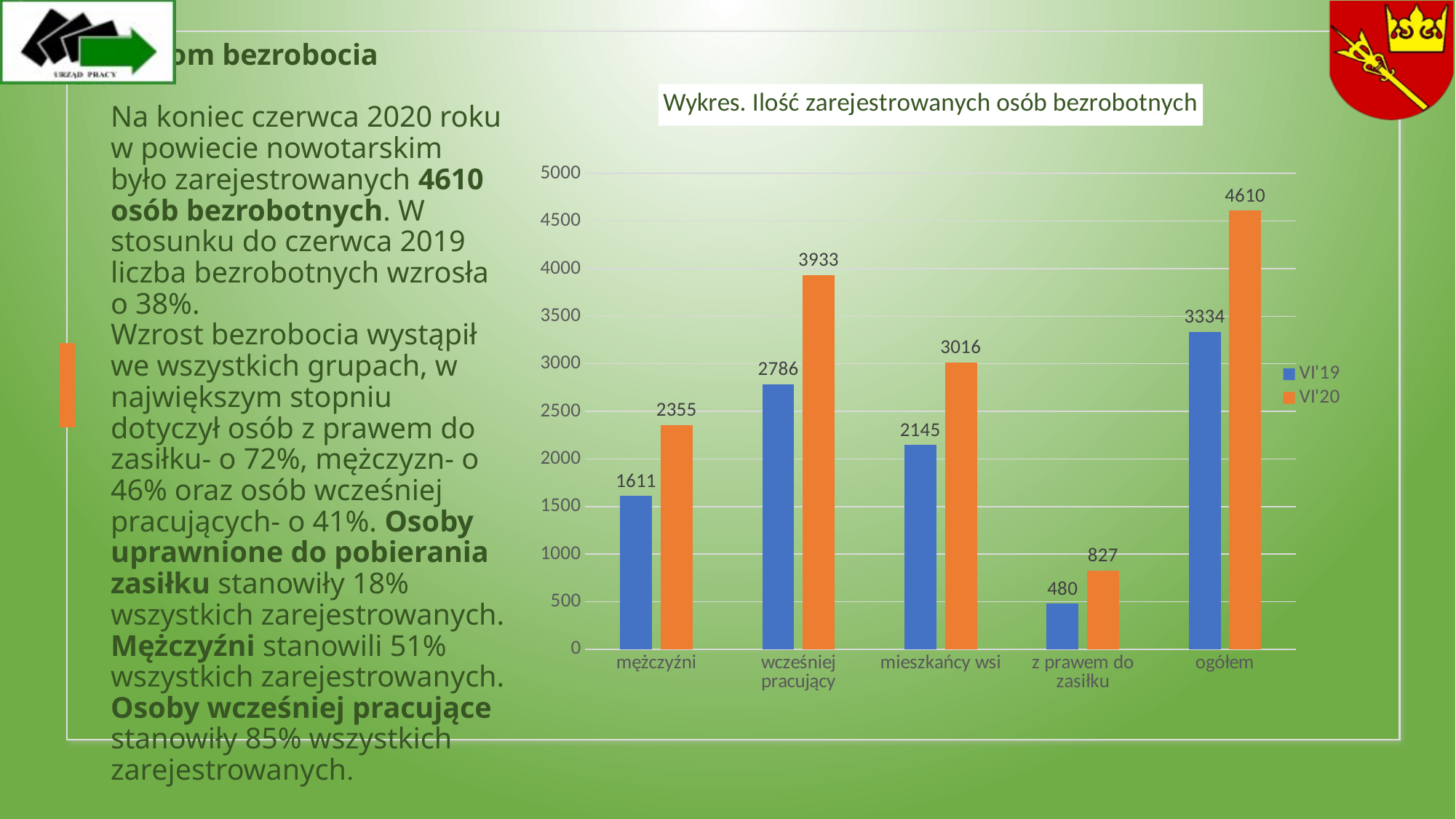
How many series does the legend list? 2 What is the value for mężczyźni in the VI'20 series? 2355 Which is larger: the VI'19 value for mieszkańcy wsi or the VI'19 value for wcześniej pracujący? wcześniej pracujący Which category has the lowest VI'19 value? z prawem do zasiłku What kind of chart is shown? bar chart Which colour represents the VI'20 series? orange What is the title of the chart? Wykres. Ilość zarejestrowanych osób bezrobotnych What is the value for z prawem do zasiłku in the VI'19 series? 480 How many categories are shown on the x axis? 5 What is the value for wcześniej pracujący in the VI'20 series? 3933 Which category has the highest VI'20 value? ogółem What is the difference between the VI'20 and VI'19 values for ogółem? 1276